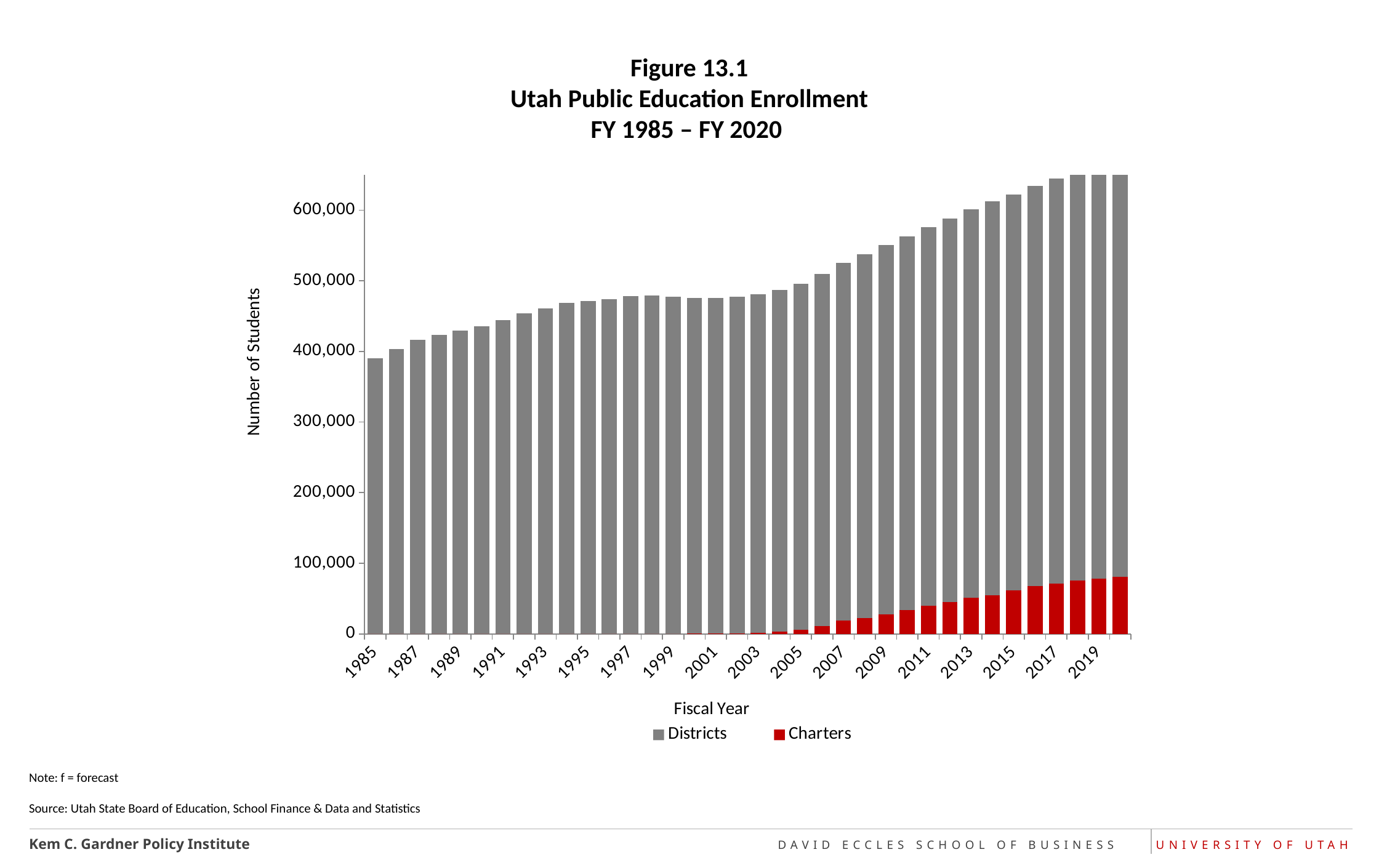
Does total enrollment generally rise or fall from 1985 to 2020? Rise Which fiscal year has the larger Charters enrollment, 2010 or 2019? 2019 Which fiscal year has the lowest total enrollment? 1985 Which fiscal year has the larger total enrollment, 2000 or 2010? 2010 What is the title of the chart? Figure 13.1 Utah Public Education Enrollment FY 1985 – FY 2020 How many fiscal years (bars) are plotted in the chart? 36 What kind of chart is shown on the slide? Stacked bar chart Is the total enrollment for 1985 greater or less than 400,000? less How many series does the legend list? 2 Is the total enrollment for 2020 greater or less than 600,000? greater Which two series are listed in the legend? Districts and Charters Is the Charters enrollment for 2020 greater or less than 100,000? less